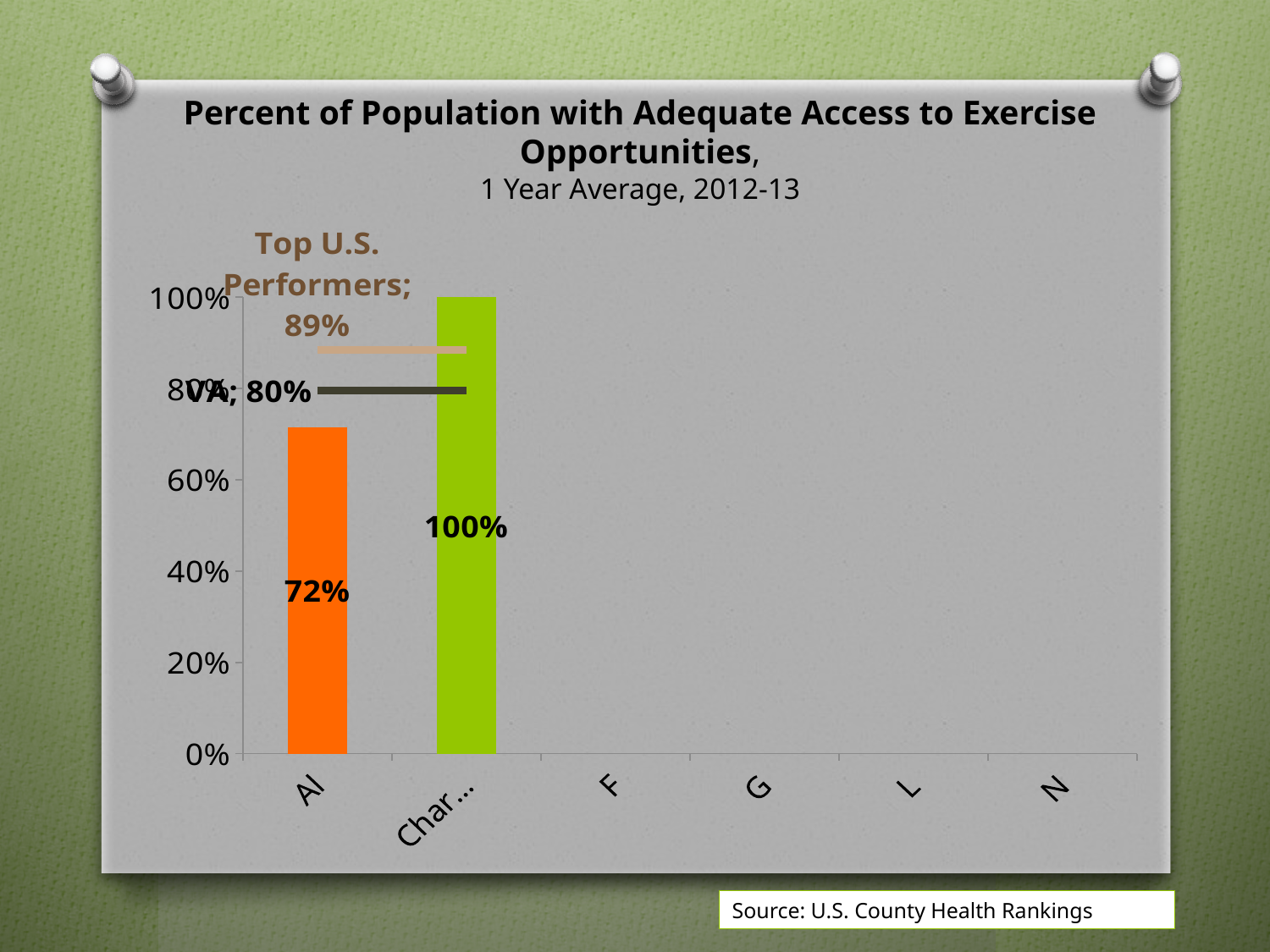
How many bars are plotted on the chart? 2 What is the difference between the green bar's value (100%) and the value for Al? 28% What is the difference between the Top U.S. Performers value and the VA value? 9% What value is given for VA? 80% What value is given for Top U.S. Performers? 89% What source is cited for the chart? U.S. County Health Rankings Is the value for Al greater or less than 80%? less Which is larger, the value for Al or the value for VA? VA Which is taller, the orange bar for Al or the green bar? the green bar What kind of chart is shown on the slide? bar chart What is the value for Al? 72% What is the value shown on the green bar (labelled "Char...")? 100%